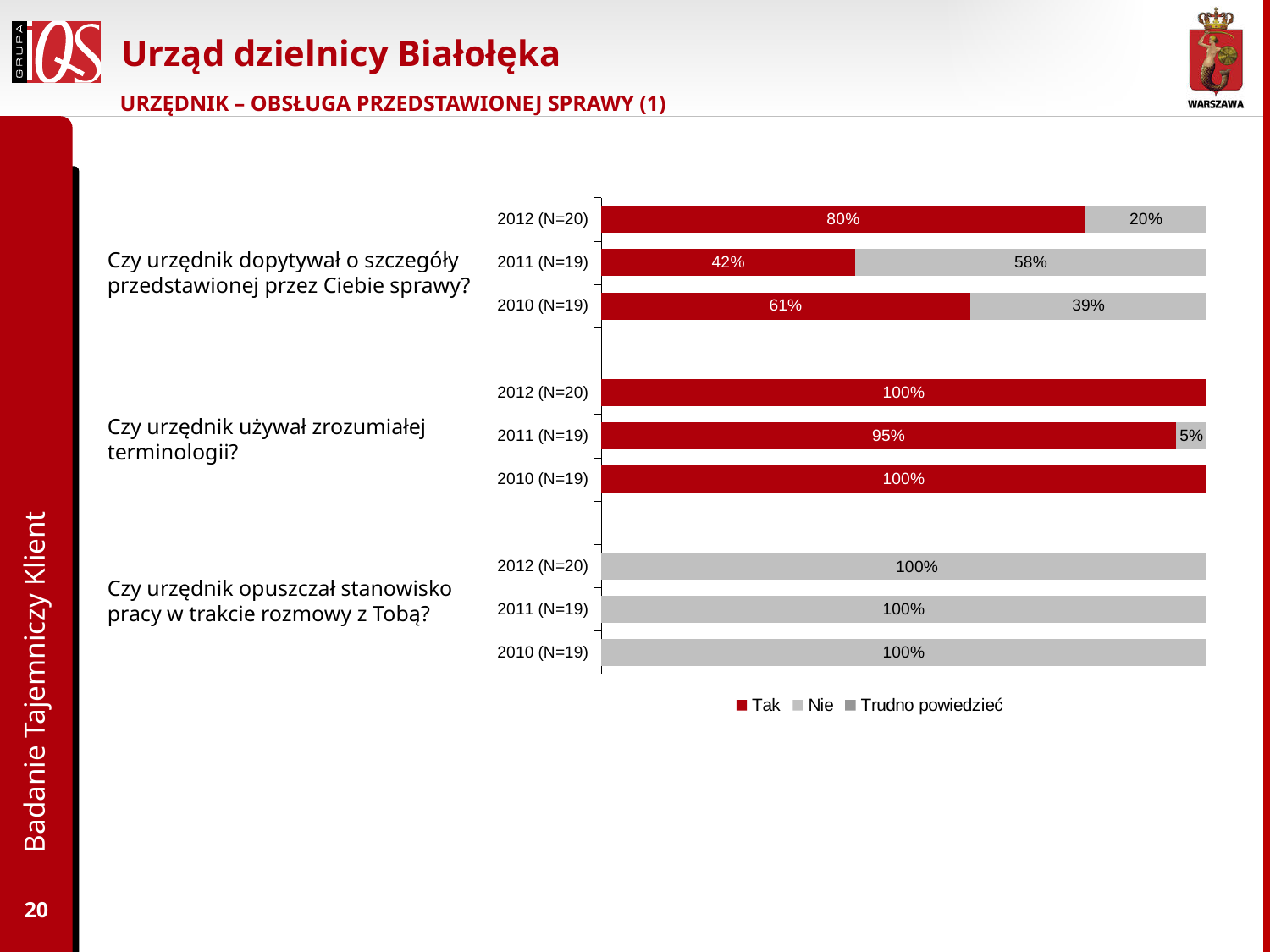
For the question "Czy urzędnik dopytywał o szczegóły przedstawionej przez Ciebie sprawy?", what is the "Tak" value for 2012 (N=20)? 80% For the question "Czy urzędnik używał zrozumiałej terminologii?", what is the "Tak" value for 2012 (N=20)? 100% How many series does the legend list? 3 For the question "Czy urzędnik opuszczał stanowisko pracy w trakcie rozmowy z Tobą?", what is the "Nie" value for 2010 (N=19)? 100% For the question "Czy urzędnik używał zrozumiałej terminologii?", what is the "Nie" value for 2011 (N=19)? 5% For the question "Czy urzędnik dopytywał o szczegóły przedstawionej przez Ciebie sprawy?", what is the "Tak" value for 2010 (N=19)? 61% For the question "Czy urzędnik dopytywał o szczegóły przedstawionej przez Ciebie sprawy?", which year has the lowest "Tak" value? 2011 (N=19) For the question "Czy urzędnik dopytywał o szczegóły przedstawionej przez Ciebie sprawy?", which year has the highest "Tak" value? 2012 (N=20) For the question "Czy urzędnik dopytywał o szczegóły przedstawionej przez Ciebie sprawy?", what is the difference between the "Tak" values for 2012 (N=20) and 2011 (N=19)? 38% What type of chart is shown on the slide? bar chart For the question "Czy urzędnik dopytywał o szczegóły przedstawionej przez Ciebie sprawy?", what is the "Nie" value for 2011 (N=19)? 58% What are the legend entries of the chart? Tak, Nie, Trudno powiedzieć